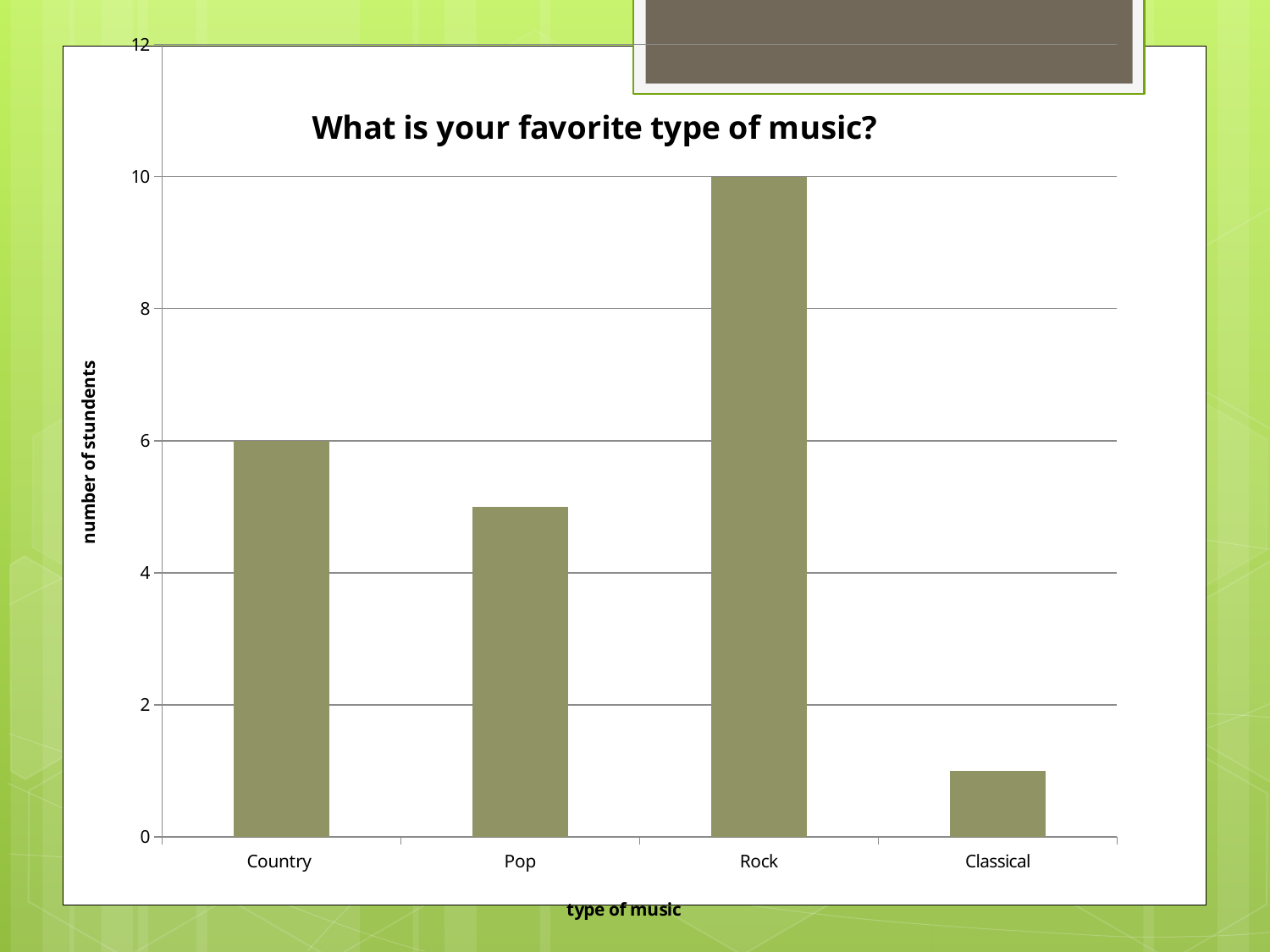
What kind of chart is shown on the slide? bar chart How many types of music are shown on the x axis? 4 Which is larger, the value for Country or the value for Pop? Country What is the difference between the values for Rock and Country? 4 Is the value for Classical greater or less than 2? less Which type of music has the lowest number of students? Classical What is the label of the x axis? type of music Is the value for Pop greater or less than 4? greater What is the title of the chart? What is your favorite type of music? Which type of music has the highest number of students? Rock What is the value for Country? 6 What is the value for Rock? 10